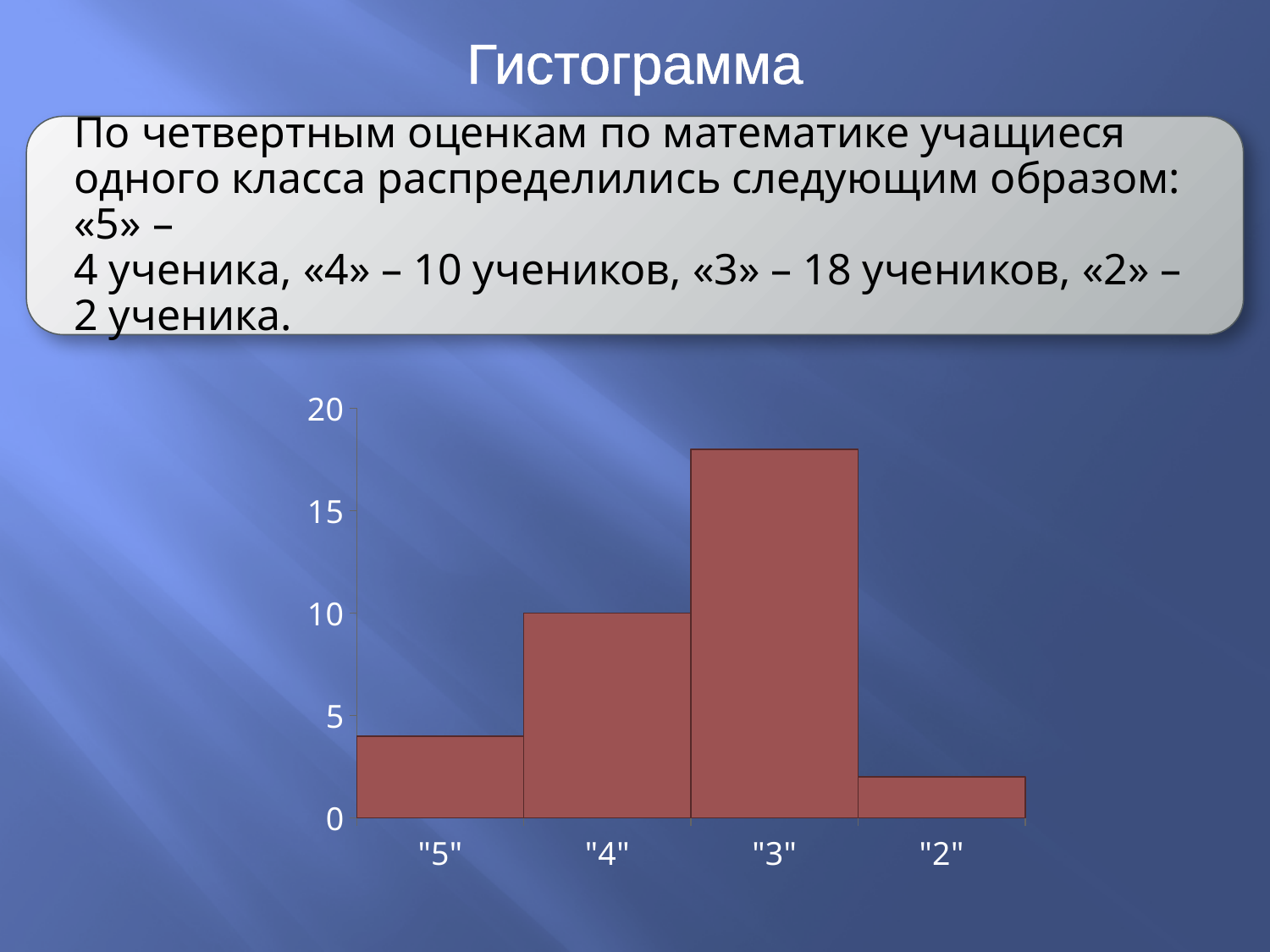
Which category has the highest bar? "3" What is the value for the category "4"? 10 Is the value for "5" greater or less than 5? less What is the value for the category "3"? 18 What kind of chart is shown on the slide? bar chart Which category has the lowest bar? "2" Is the value for "3" greater or less than 15? greater Which is larger, the value for "4" or the value for "5"? "4" What is the value for the category "2"? 2 What is the difference between the values for "3" and "4"? 8 How many categories are shown on the x axis of the chart? 4 What is the value for the category "5"? 4